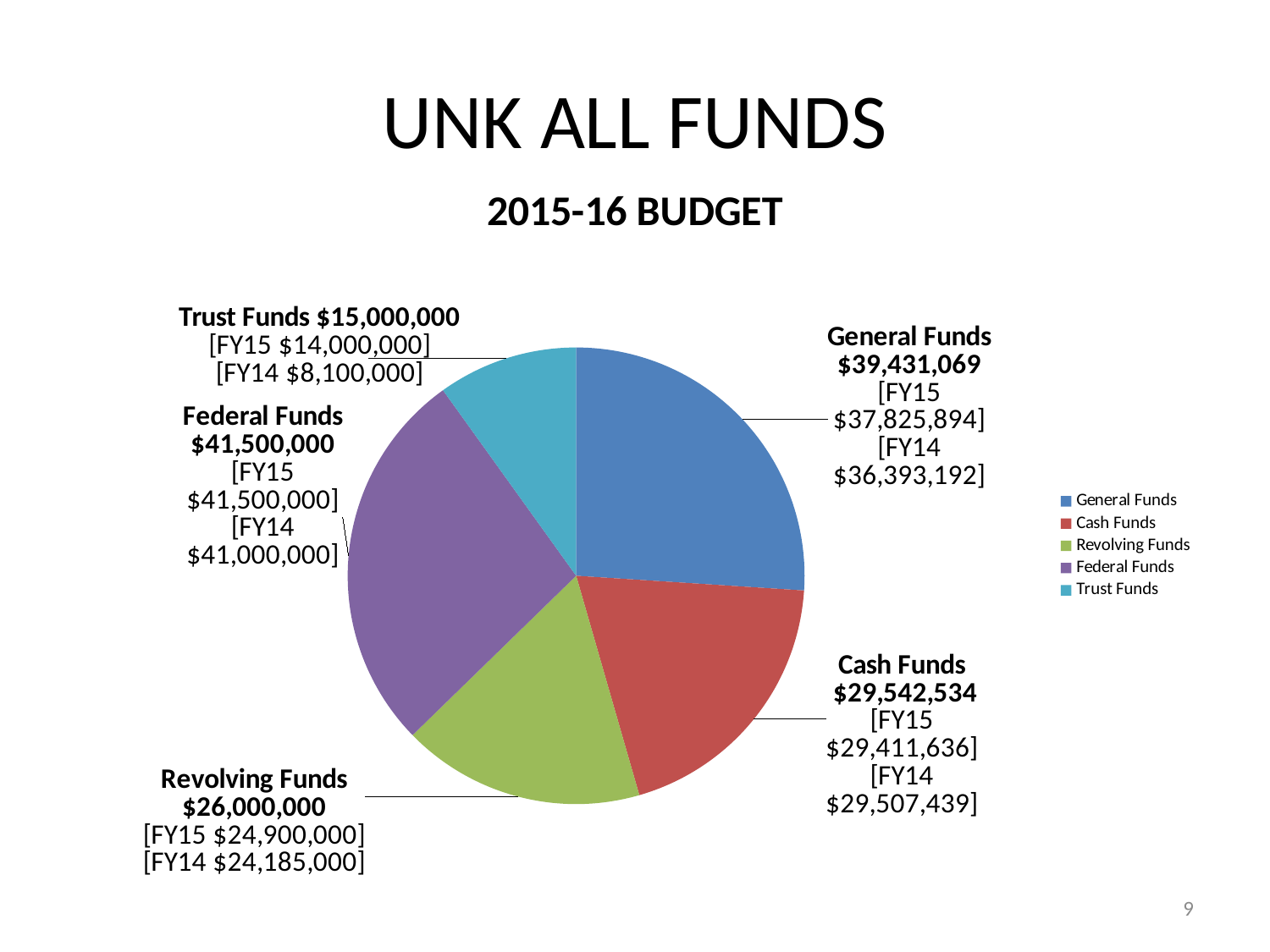
Which fund category has the smallest slice of the pie? Trust Funds Which is larger, Cash Funds or Revolving Funds? Cash Funds How many fund categories does the legend list? 5 What kind of chart is shown on the slide? pie chart What is the 2015-16 budget value for Cash Funds? $29,542,534 What is the 2015-16 budget value for Federal Funds? $41,500,000 Which fund category has the largest slice of the pie? Federal Funds What was the FY14 value for Trust Funds shown in the label? $8,100,000 What was the FY15 value for General Funds shown in the label? $37,825,894 What is the difference between the Cash Funds and Revolving Funds values? $3,542,534 What colour is the Revolving Funds slice? green What is the difference between the Federal Funds and General Funds values? $2,068,931